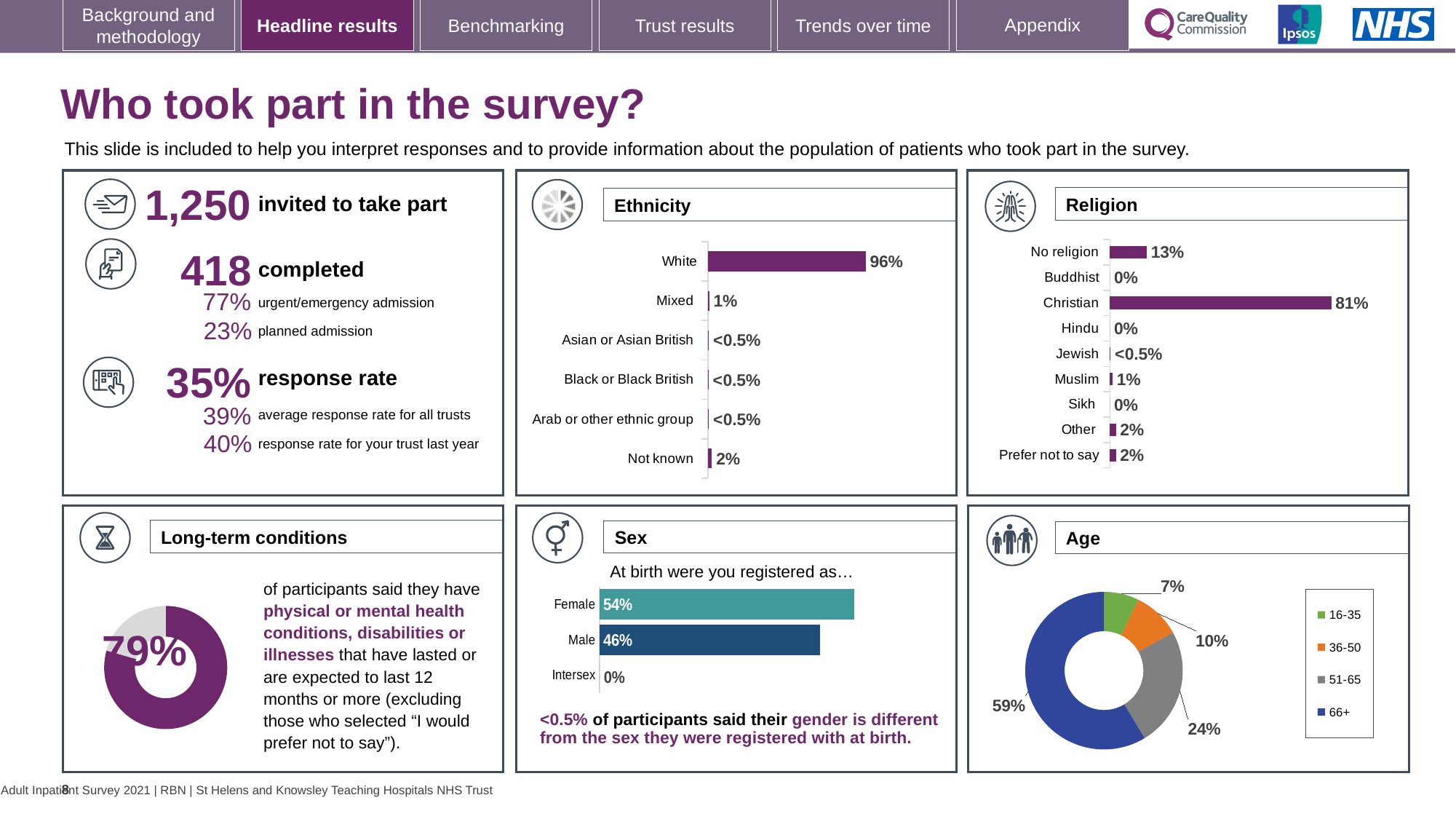
In the Age chart, what share of participants were aged 66+? 59% What type of chart is the Age chart? Donut chart In the Ethnicity chart, what is the value shown for Not known? 2% In the Religion chart, what is the difference between the Christian and No religion percentages? 68% In the Ethnicity chart, what percentage of participants were White? 96% How many categories are shown in the Religion chart? 9 In the Religion chart, what percentage of participants were Christian? 81% In the Ethnicity chart, which ethnic group has the highest percentage? White In the Sex chart, what percentage of participants were registered as Female at birth? 54% How many categories are shown in the Ethnicity chart? 6 In the Religion chart, which is larger, Other or Muslim? Other In the Sex chart, what is the difference between the Female and Male percentages? 8%